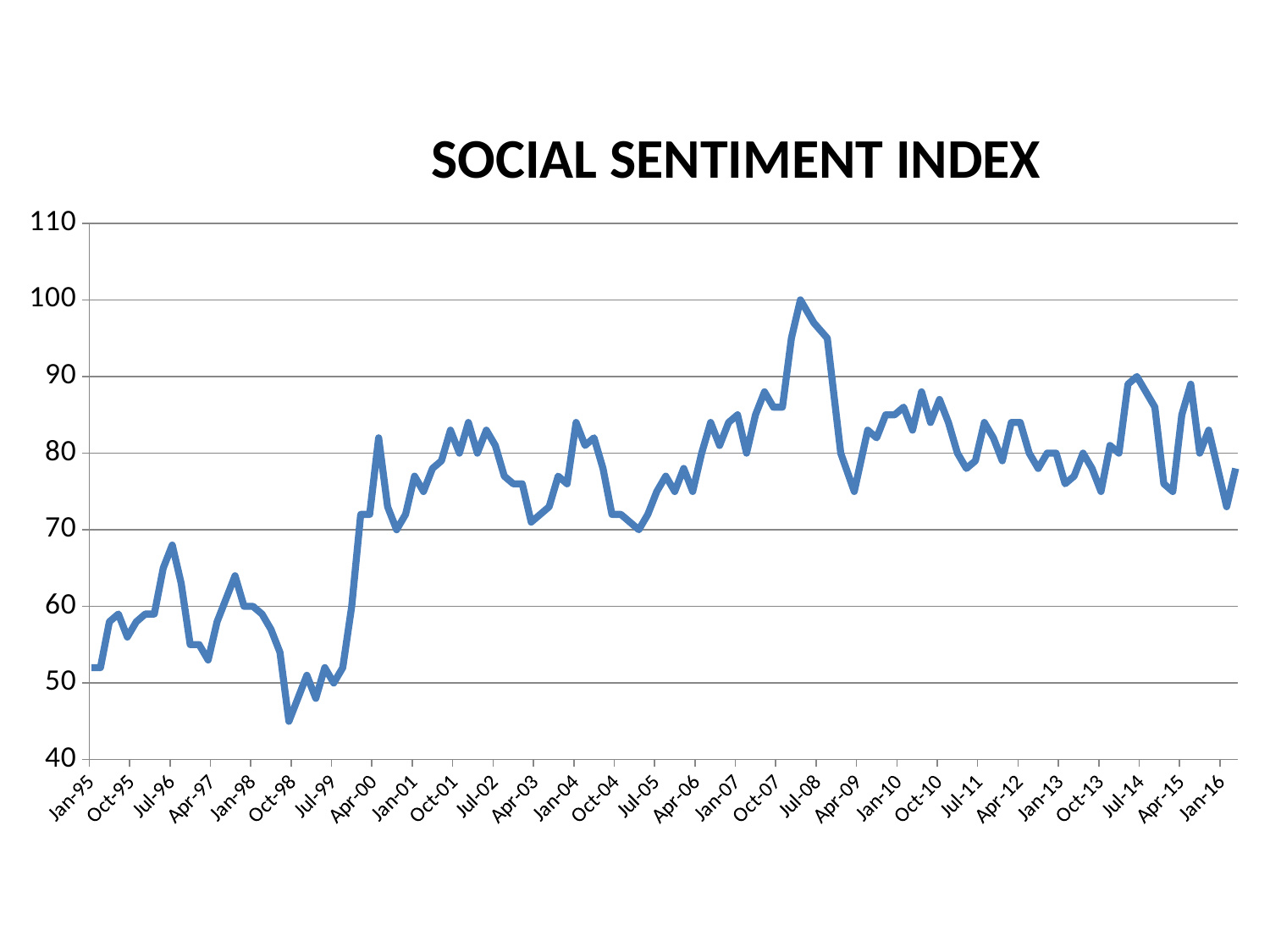
Is the value for Jul-08 greater or less than 90? greater Is the value for Apr-15 greater or less than 80? less Around which x-axis label does the Social Sentiment Index reach its highest value? Jul-08 Is the value for Jul-96 greater or less than 70? less What is the title of the chart? SOCIAL SENTIMENT INDEX Which is larger, the value at Jul-08 or the value at Oct-98? Jul-08 Does the Social Sentiment Index overall rise or fall from Jan-95 to Apr-00? rise What kind of chart is shown on the slide? line chart Around which x-axis label does the Social Sentiment Index reach its lowest value? Oct-98